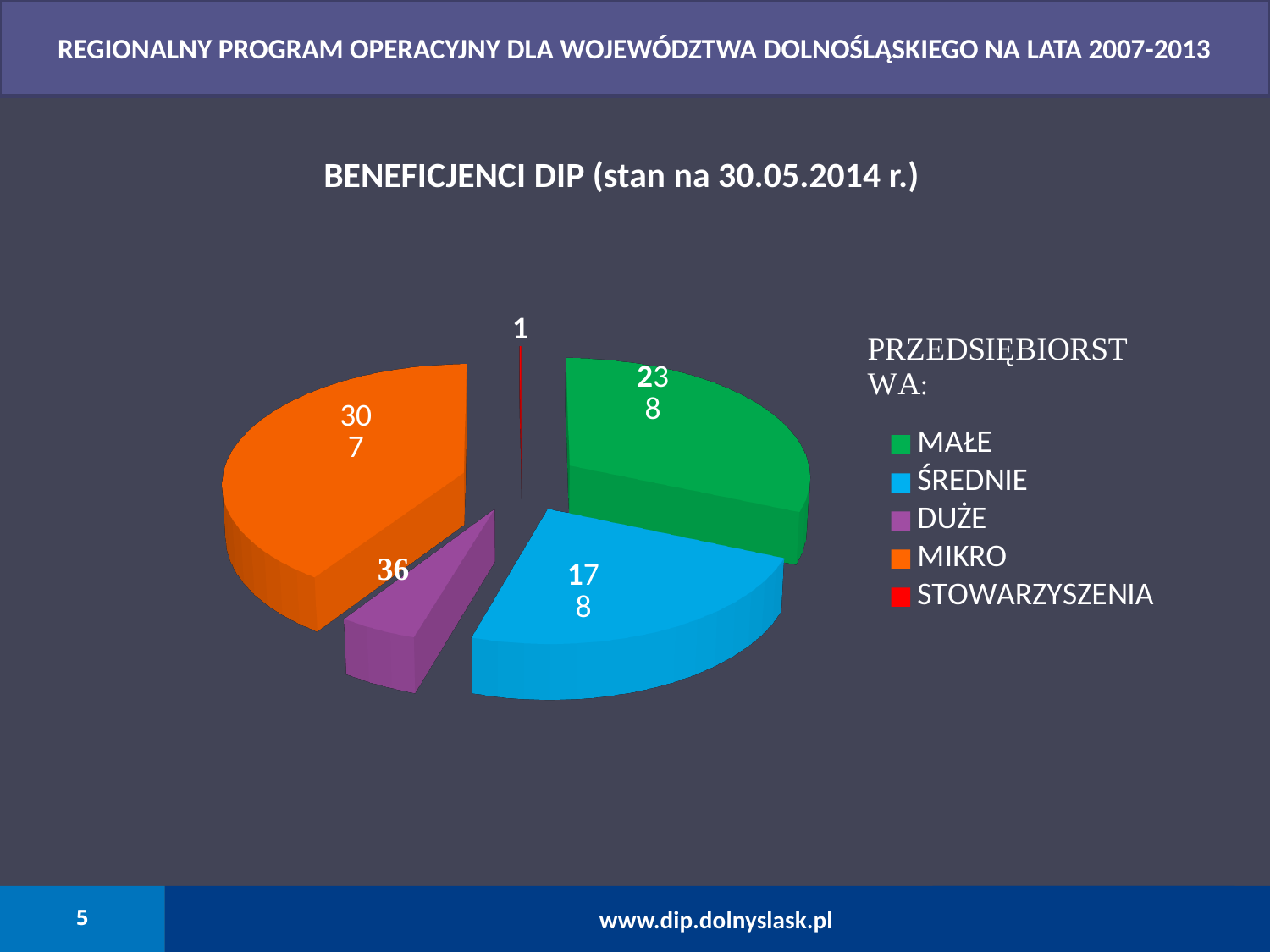
What is the value for MIKRO? 307 What is the value for MAŁE? 238 How many slices does the pie chart have? 5 What type of chart is shown on the slide? Pie chart What is the value for STOWARZYSZENIA? 1 Which is larger, DUŻE or STOWARZYSZENIA? DUŻE What is the value for DUŻE? 36 What colour is the MIKRO slice? Orange How many entries does the legend list? 5 Which category has the smallest slice? STOWARZYSZENIA Which category has the largest slice? MIKRO What is the title of the chart? BENEFICJENCI DIP (stan na 30.05.2014 r.)